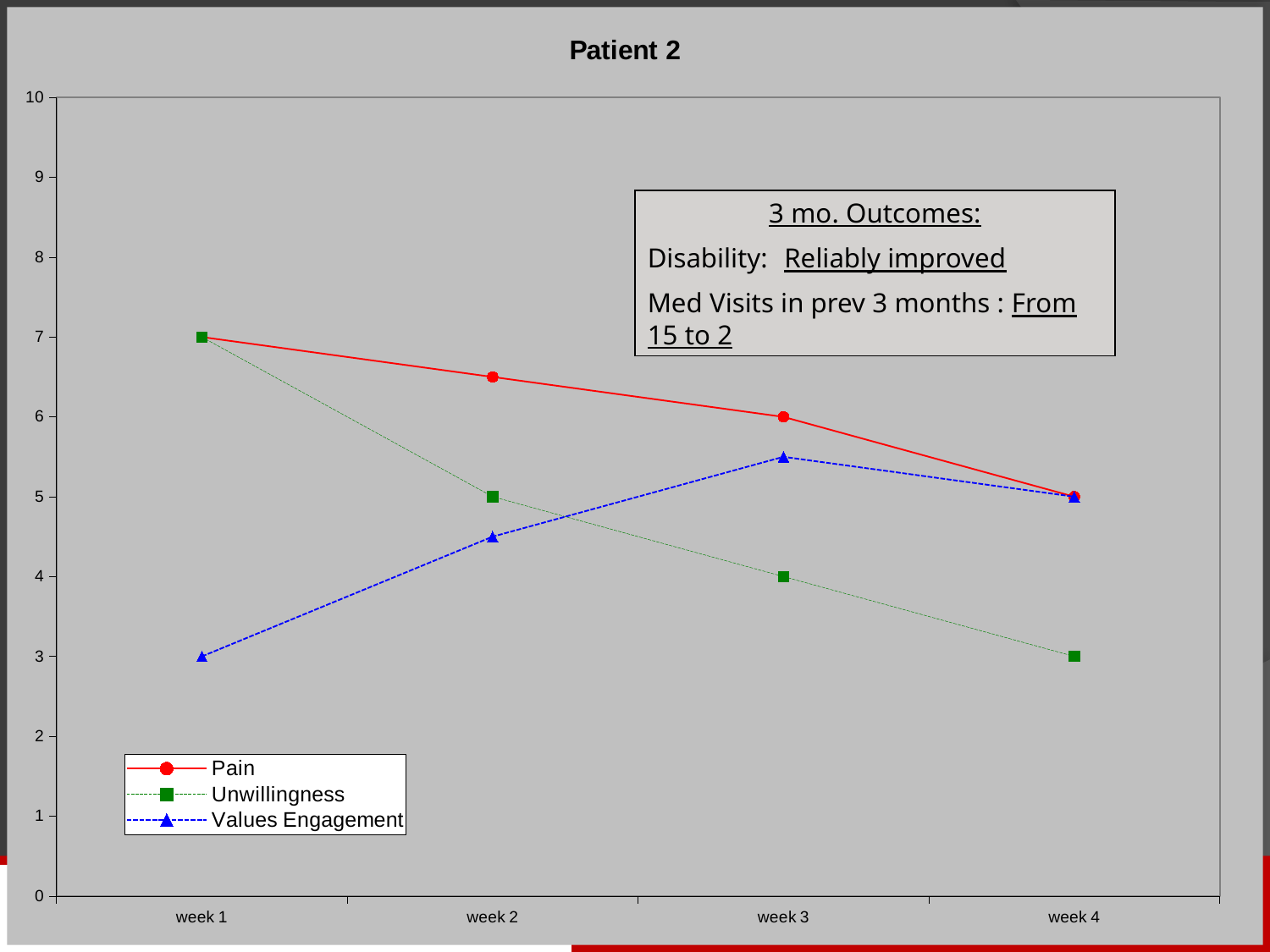
What is the Unwillingness value at week 4? 3 By how much does Unwillingness fall from week 1 to week 4? 4 What kind of chart is shown on the slide? line chart Is the Pain value at week 2 greater or less than 6? greater What is the Unwillingness value at week 1? 7 What is the Pain value at week 4? 5 At week 3, which is larger, Pain or Unwillingness? Pain Is the Values Engagement value at week 3 greater or less than 5? greater What is the Values Engagement value at week 1? 3 How many weeks are plotted along the x axis? 4 How many series does the legend list? 3 What is the title of the chart? Patient 2